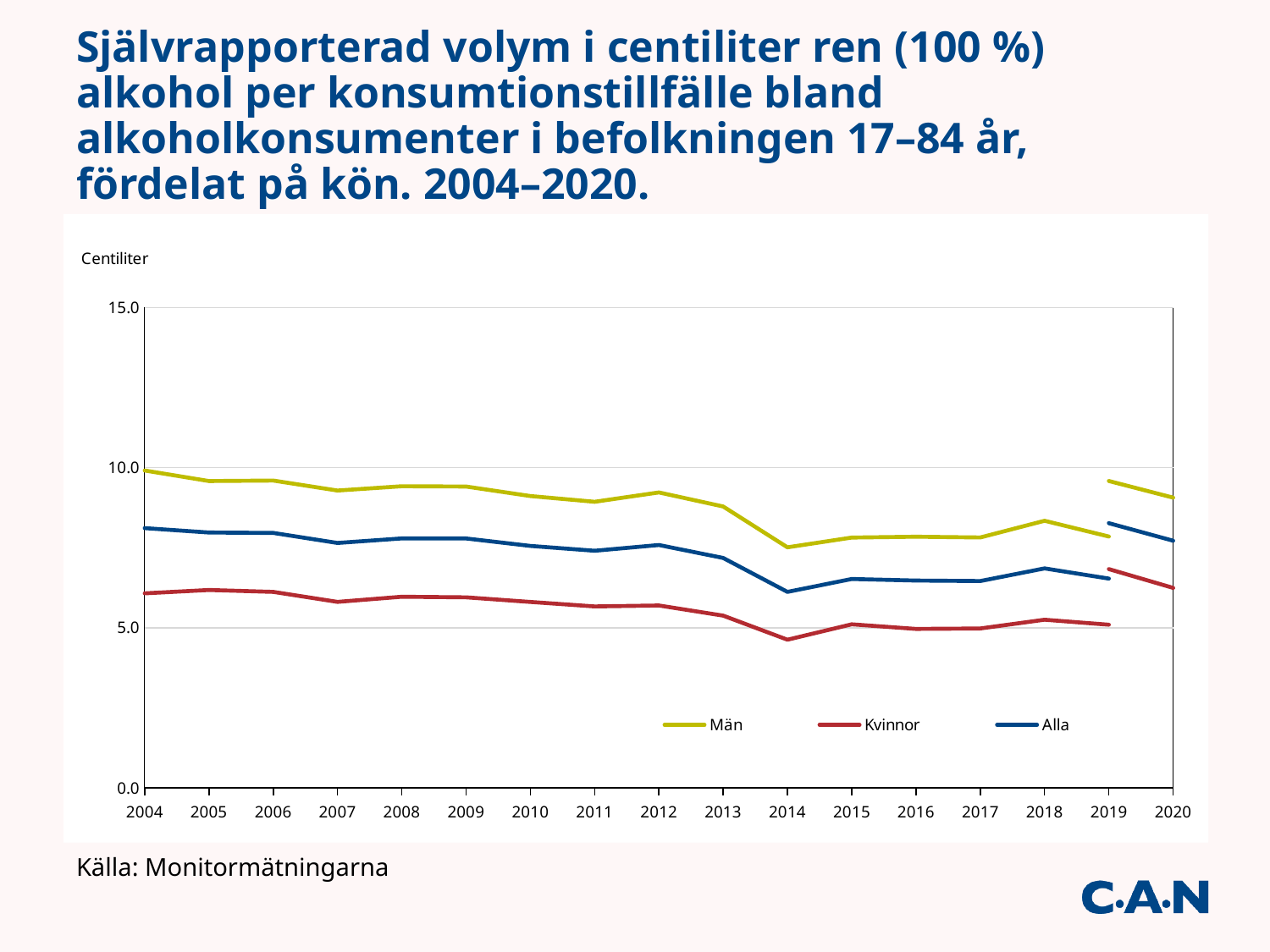
Which series are listed in the legend? Män, Kvinnor, Alla What is the label on the vertical axis? Centiliter Which series has the larger value in 2010, Män or Kvinnor? Män Is the value for Kvinnor in 2014 greater or less than 5.0? less Is the value for Kvinnor in 2004 greater or less than 5.0? greater How many years are shown along the x axis? 17 Is the value for Alla in 2014 greater or less than 5.0? greater What kind of chart is shown on the slide? Line chart In which year is the value for Kvinnor lowest? 2014 How many series does the legend list? 3 In which year is the value for Män highest? 2004